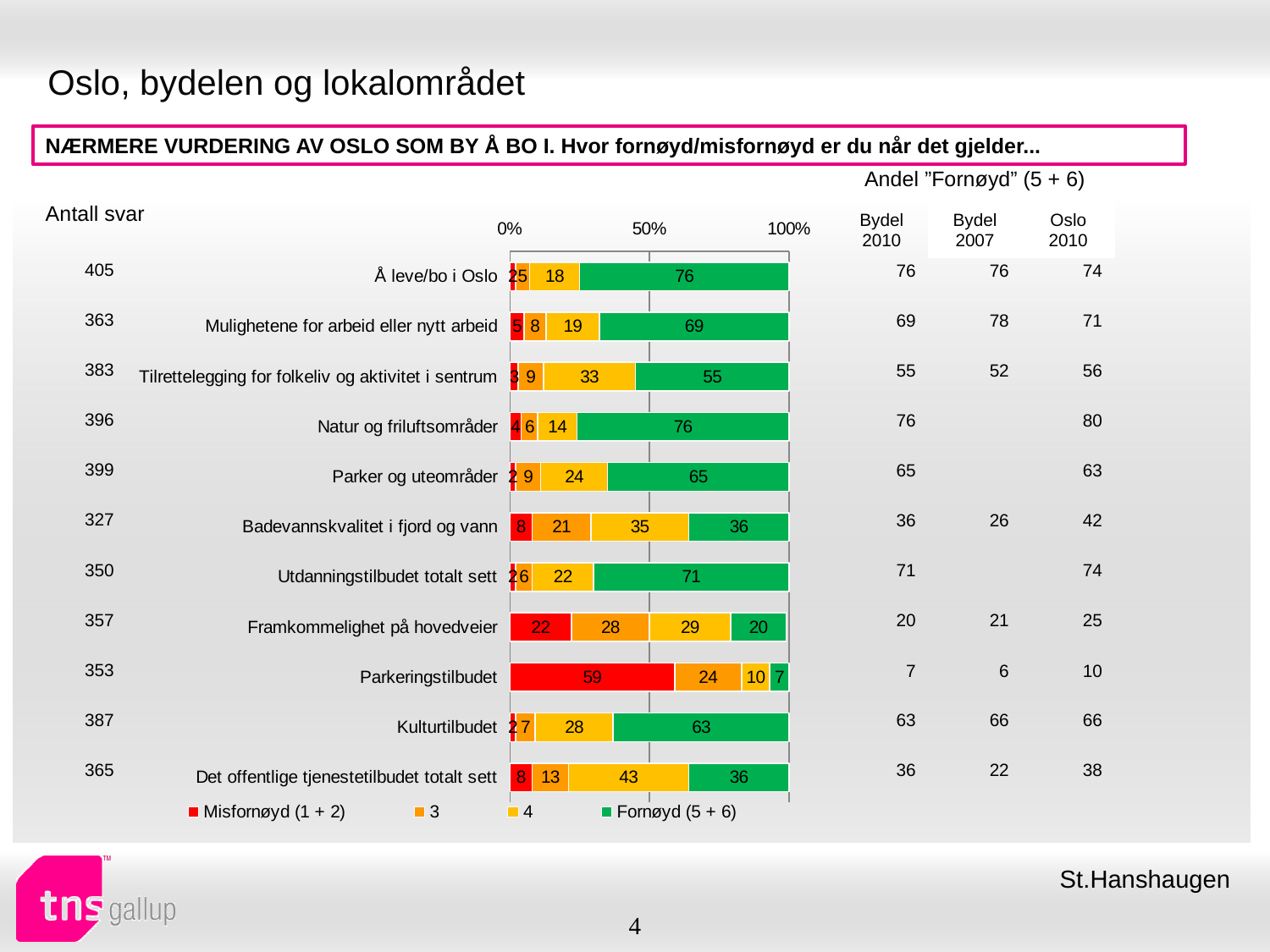
What is the first entry in the chart legend? Misfornøyd (1 + 2) How many categories are plotted in the chart? 11 Which category has the highest Misfornøyd (1 + 2) value? Parkeringstilbudet What is the Fornøyd (5 + 6) value for Parkeringstilbudet? 7 What is the difference between the Fornøyd (5 + 6) values for Parker og uteområder and Kulturtilbudet? 2 How many series does the chart legend list? 4 Which category has the lowest Fornøyd (5 + 6) value? Parkeringstilbudet What is the Misfornøyd (1 + 2) value for Parkeringstilbudet? 59 What is the total of the stacked bar for Parkeringstilbudet? 100 What type of chart is shown on the slide? bar chart What is the Fornøyd (5 + 6) value for Badevannskvalitet i fjord og vann? 36 Which has a larger Fornøyd (5 + 6) value: Mulighetene for arbeid eller nytt arbeid or Tilrettelegging for folkeliv og aktivitet i sentrum? Mulighetene for arbeid eller nytt arbeid